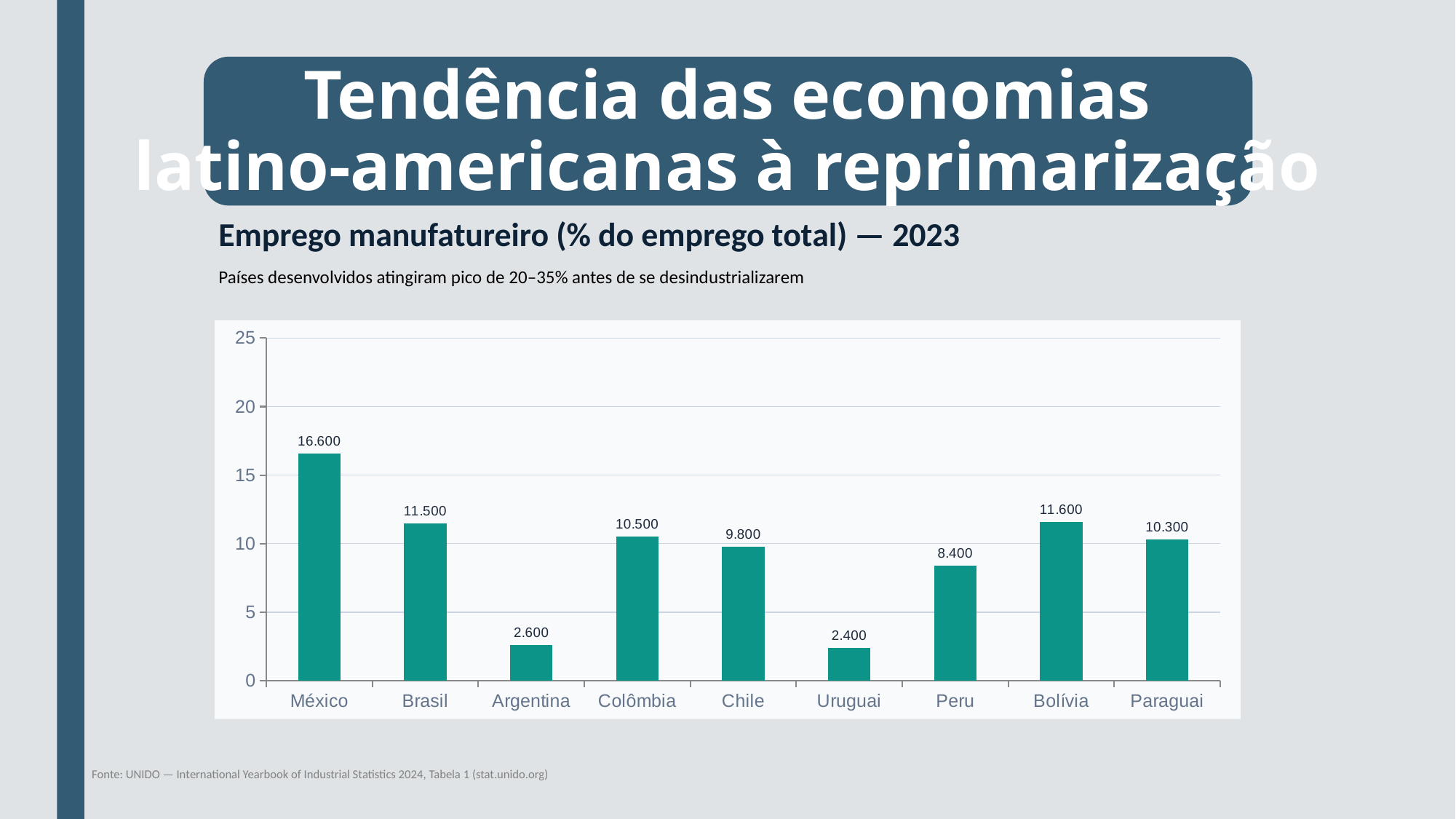
How many countries are shown in the chart? 9 What is the value for México? 16.600 What is the difference between the values for Chile and Peru? 1.400 What is the value for Uruguai? 2.400 Is the value for Chile greater or less than 10? less Which country has the lowest value? Uruguai Which is larger, the value for Chile or the value for Peru? Chile What is the difference between the values for México and Brasil? 5.100 What kind of chart is shown on the slide? bar chart What is the title of the chart? Emprego manufatureiro (% do emprego total) — 2023 Which country has the highest value? México What is the value for Bolívia? 11.600